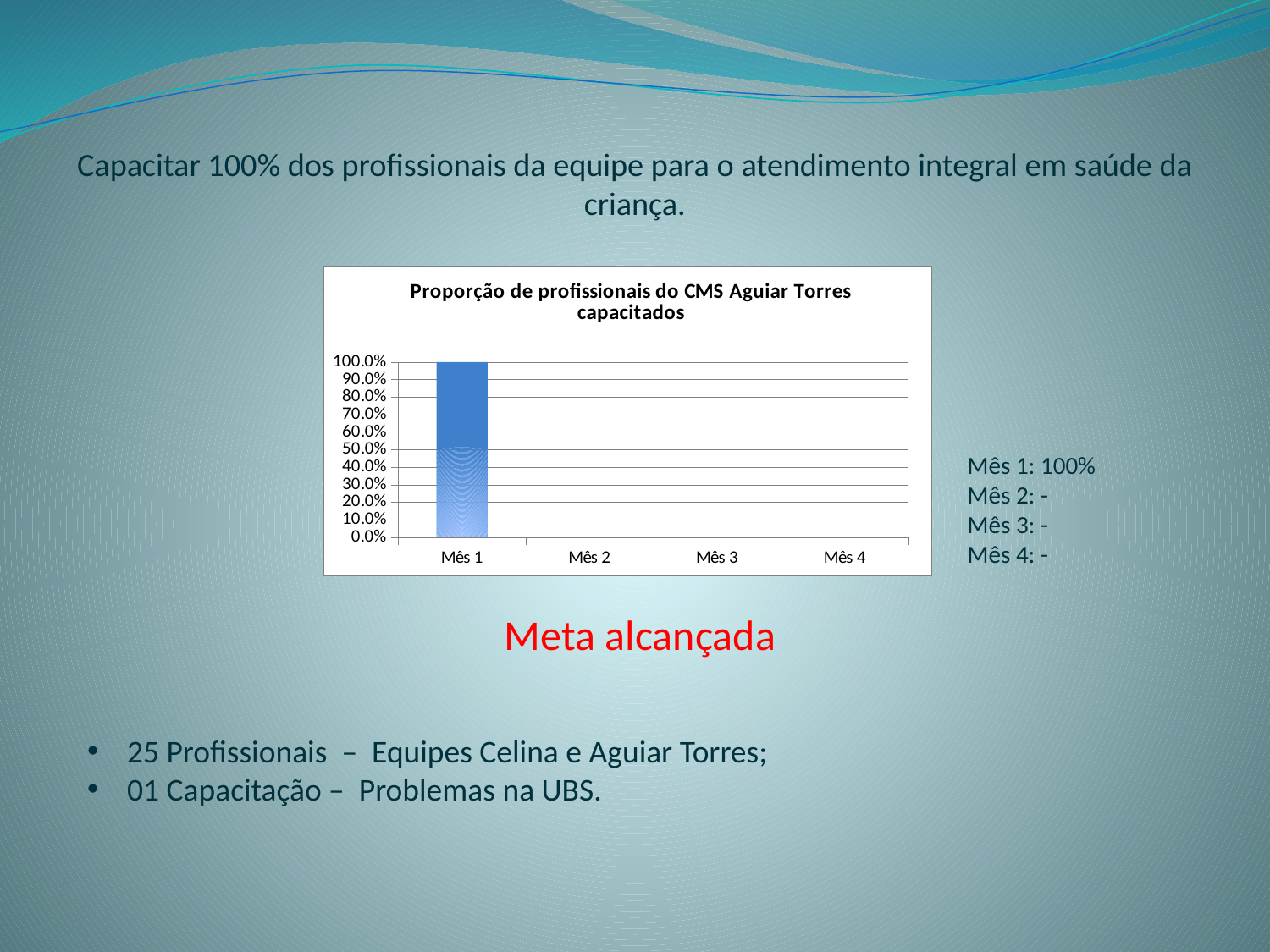
Is the value for Mês 1 greater or less than 50.0%? greater Which months have no bar plotted in the chart? Mês 2, Mês 3, Mês 4 What is the value for Mês 1 in the chart? 100.0% How many months (categories) are shown on the x axis of the chart? 4 Which is larger, the value for Mês 1 or the value for Mês 2? Mês 1 Which month has the highest value in the chart? Mês 1 Is the value for Mês 1 greater or less than 90.0%? greater What is the title of the chart? Proporção de profissionais do CMS Aguiar Torres capacitados What kind of chart is shown on the slide? bar chart What is the highest value shown on the y axis of the chart? 100.0%